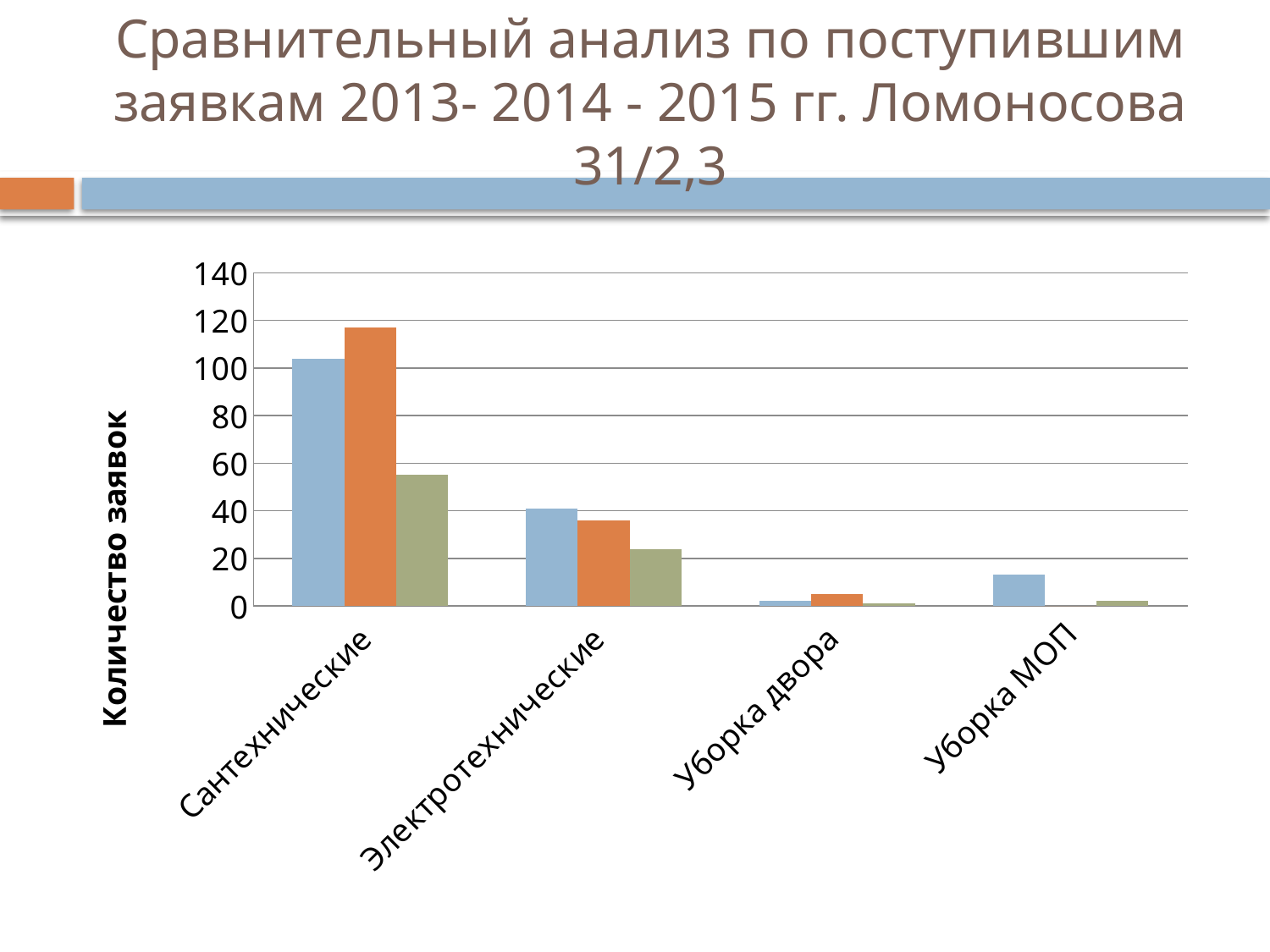
Which category has the lowest bars overall in the chart? Уборка двора Is the value of the green bar for Сантехнические greater or less than 60? less For Электротехнические, which is larger: the blue bar or the green bar? the blue bar Is the value of the blue bar for Сантехнические greater or less than 80? greater Is the value of the blue bar for Уборка МОП greater or less than 20? less How many categories are shown on the x axis of the chart? 4 What kind of chart is shown on the slide? bar chart Which category has the tallest bars in the chart? Сантехнические What is the title of the vertical axis of the chart? Количество заявок How many bars are plotted for each category in the chart? 3 For Сантехнические, which is larger: the blue bar or the orange bar? the orange bar